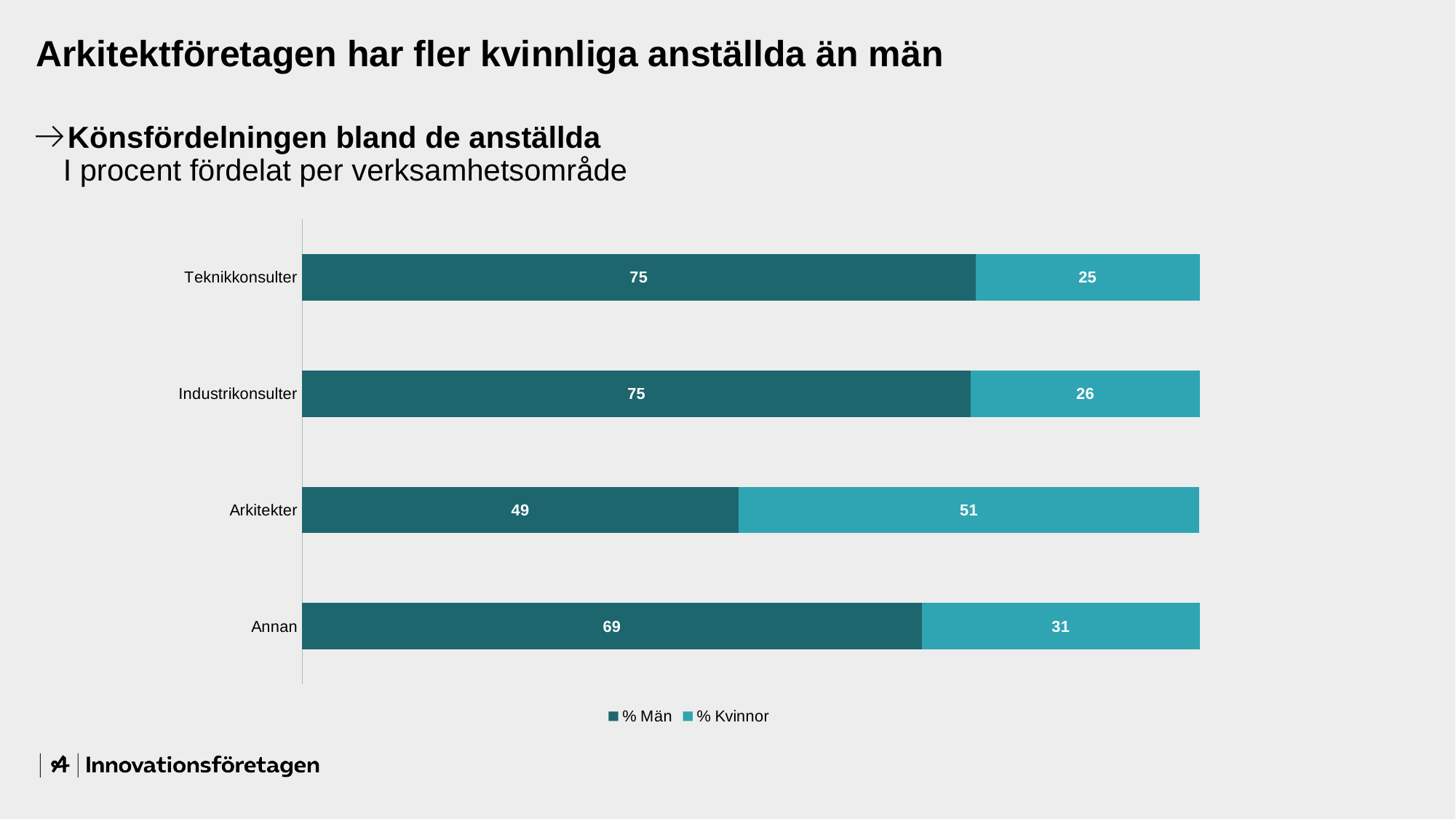
How many series does the legend list? 2 What kind of chart is shown on the slide? Stacked bar chart Which category has the highest % Kvinnor value? Arkitekter What is the % Män value for Teknikkonsulter? 75 Which category has the lowest % Män value? Arkitekter What is the total of the stacked bar for Industrikonsulter? 101 What is the % Kvinnor value for Annan? 31 Which is larger for Arkitekter, the % Män value or the % Kvinnor value? % Kvinnor What is the % Kvinnor value for Arkitekter? 51 What is the % Män value for Industrikonsulter? 75 What is the difference between the % Män and % Kvinnor values for Annan? 38 How many categories are shown on the chart? 4